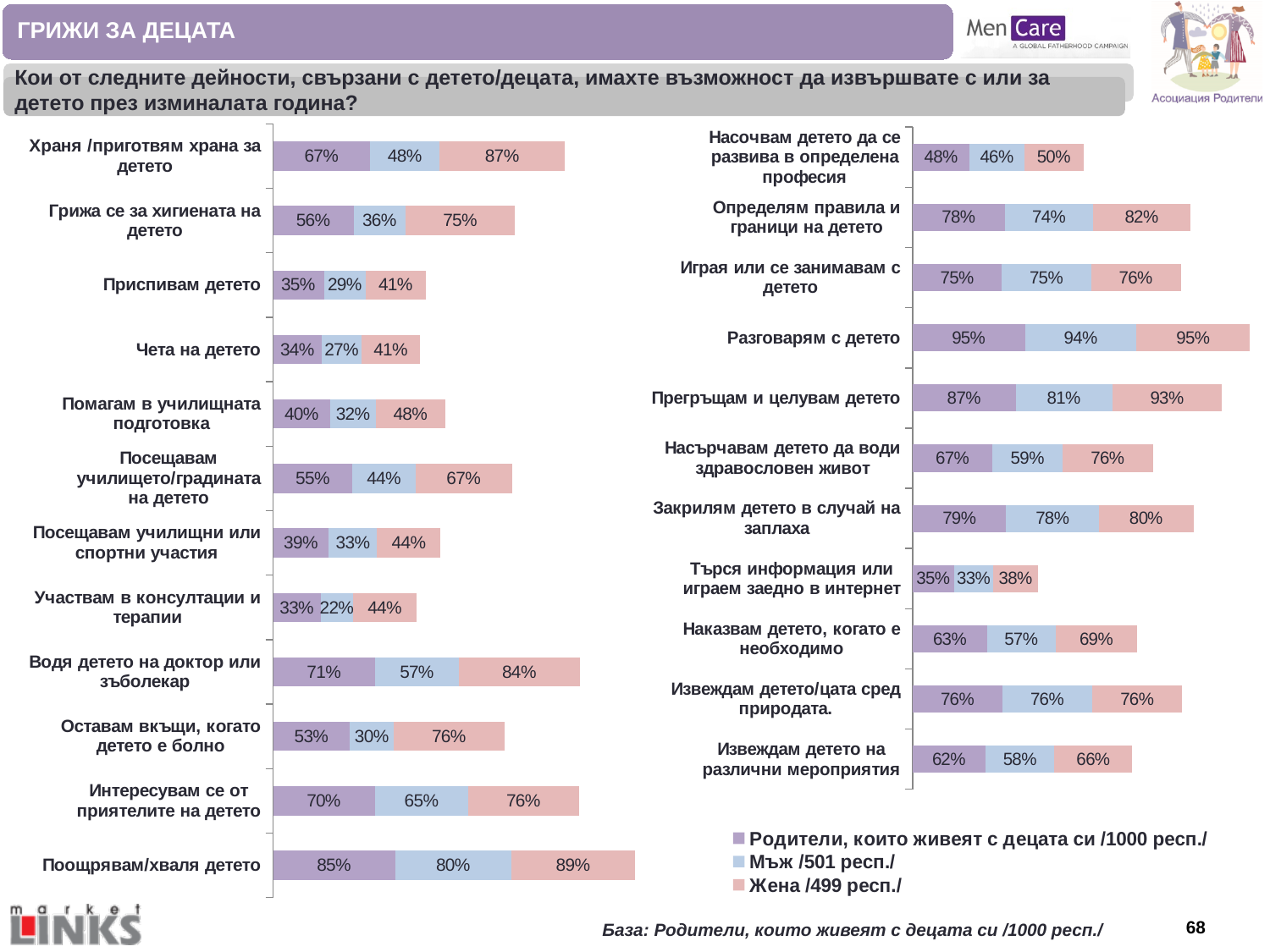
On the right chart, what is the total of the stacked bar for "Търся информация или играем заедно в интернет"? 106% On the left chart, which category has the lowest value for "Мъж"? Участвам в консултации и терапии How many categories are shown on the right chart? 11 What kind of chart is the right chart? Stacked bar chart How many categories are shown on the left chart? 12 On the right chart, which is larger for "Наказвам детето, когато е необходимо": the "Мъж" value or the "Жена" value? Жена How many series does the legend list? 3 On the left chart, what is the value for "Родители, които живеят с децата си" for "Оставам вкъщи, когато детето е болно"? 53% On the right chart, which category has the highest value for "Родители, които живеят с децата си"? Разговарям с детето On the left chart, what is the difference between the "Жена" and "Мъж" values for "Водя детето на доктор или зъболекар"? 27% On the right chart, what is the value for "Мъж" for "Прегръщам и целувам детето"? 81% On the left chart, what is the value for "Жена" for "Храня /приготвям храна за детето"? 87%